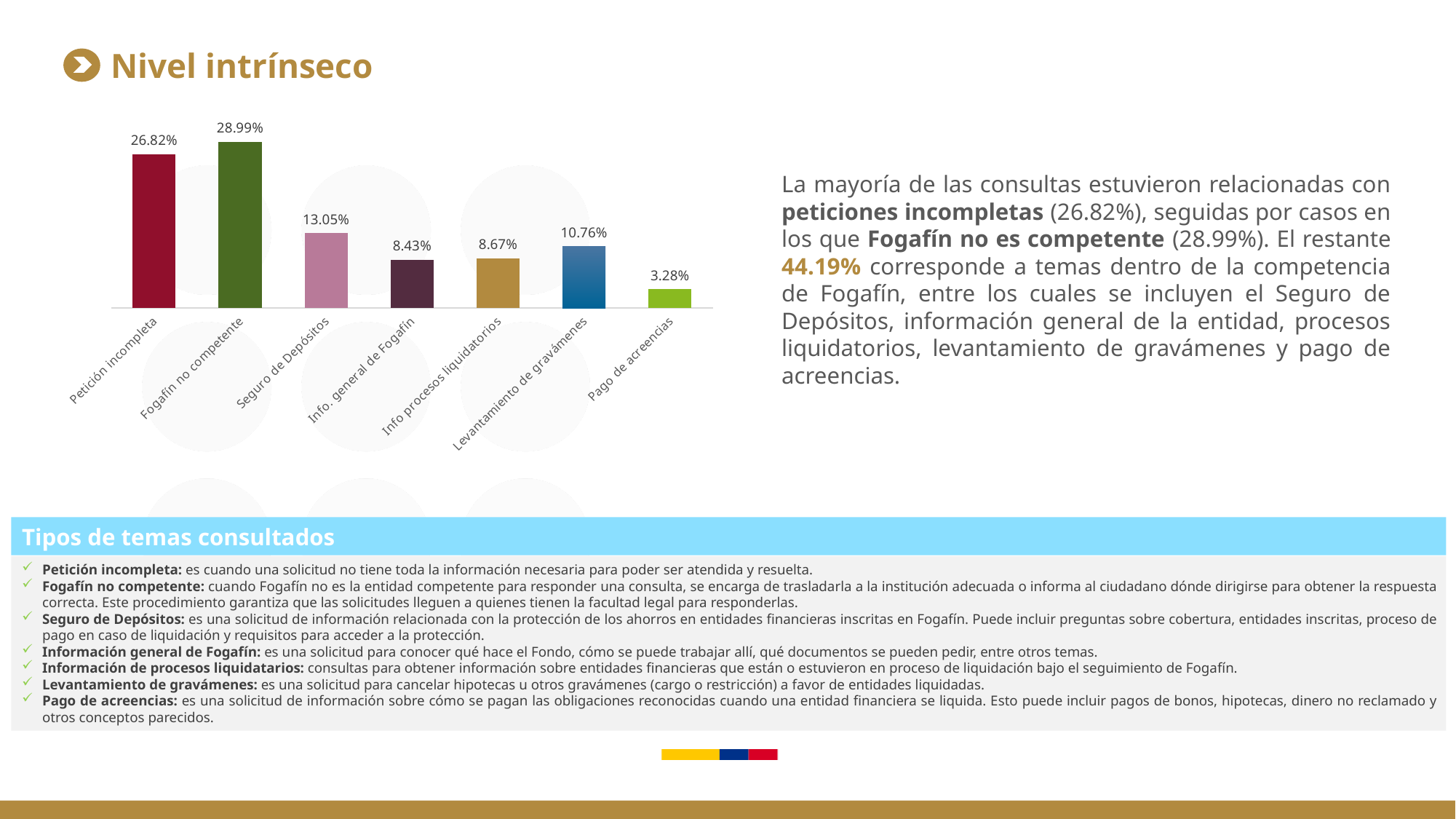
How many categories are shown in the chart? 7 Which category has the lowest value? Pago de acreencias What is the difference between Fogafín no competente and Petición incompleta? 2.17% What is the value for Seguro de Depósitos? 13.05% Which is larger, Levantamiento de gravámenes or Info procesos liquidatorios? Levantamiento de gravámenes What is the value for Pago de acreencias? 3.28% What is the value for Fogafín no competente? 28.99% What is the value for Petición incompleta? 26.82% What colour is the bar for Fogafín no competente? Green Which category has the highest value? Fogafín no competente What is the difference between Info procesos liquidatorios and Info. general de Fogafín? 0.24% What kind of chart is shown on the slide? Bar chart